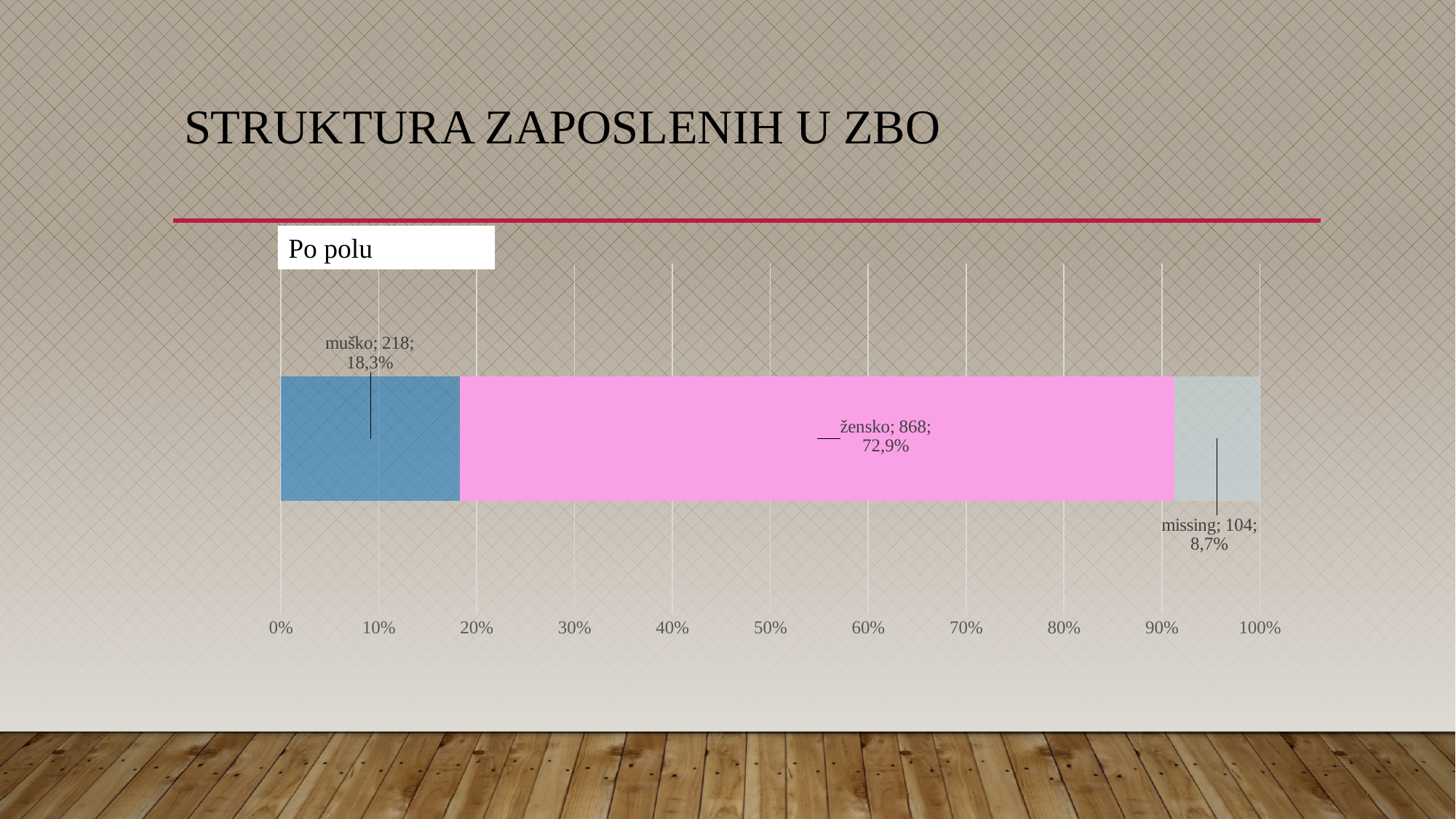
What type of chart is the Po polu chart? stacked bar chart What percentage share does žensko have in the Po polu chart? 72,9% Which category has the lowest count in the Po polu chart? missing How many categories are shown in the Po polu chart? 3 What is the title of the chart on the slide? Po polu What is the count for muško in the Po polu chart? 218 What is the difference between the žensko and muško counts in the Po polu chart? 650 What percentage is shown for muško in the Po polu chart? 18,3% What is the total of all three counts in the Po polu chart? 1190 Which category has the highest count in the Po polu chart? žensko What is the count for the missing category in the Po polu chart? 104 Which is larger in the Po polu chart, the muško count or the missing count? muško